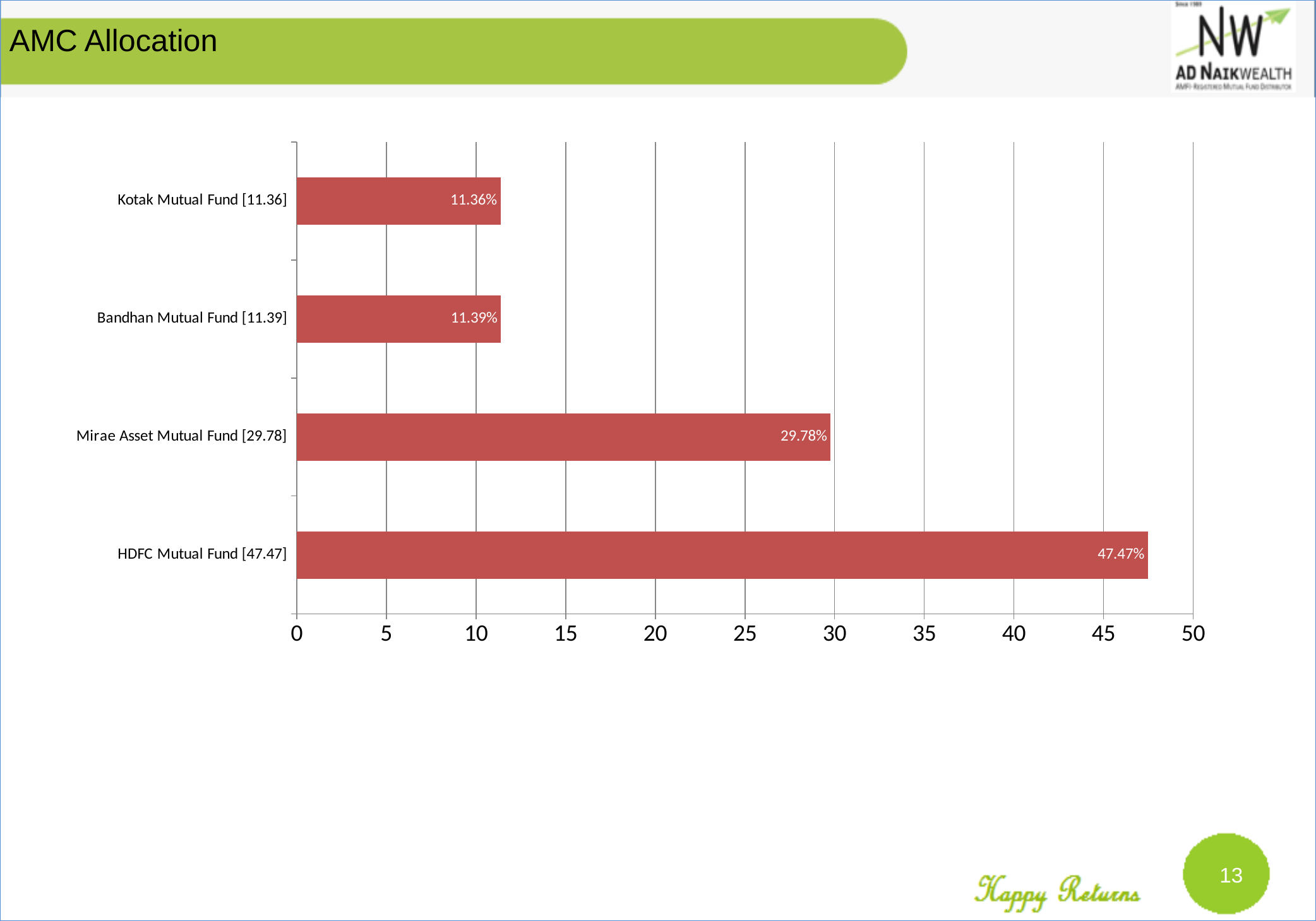
What is the value for Mirae Asset Mutual Fund? 29.78% What kind of chart is shown on the slide? Bar chart What is the difference between the values for Bandhan Mutual Fund and Kotak Mutual Fund? 0.03% How many funds are shown in the chart? 4 What is the title of the slide containing the chart? AMC Allocation What is the value for Bandhan Mutual Fund? 11.39% Which is larger, the value for Mirae Asset Mutual Fund or the value for Bandhan Mutual Fund? Mirae Asset Mutual Fund What is the value for HDFC Mutual Fund? 47.47% Which fund has the highest allocation? HDFC Mutual Fund Is the value for HDFC Mutual Fund greater or less than 45? greater What is the difference between the values for HDFC Mutual Fund and Mirae Asset Mutual Fund? 17.69% What is the value for Kotak Mutual Fund? 11.36%